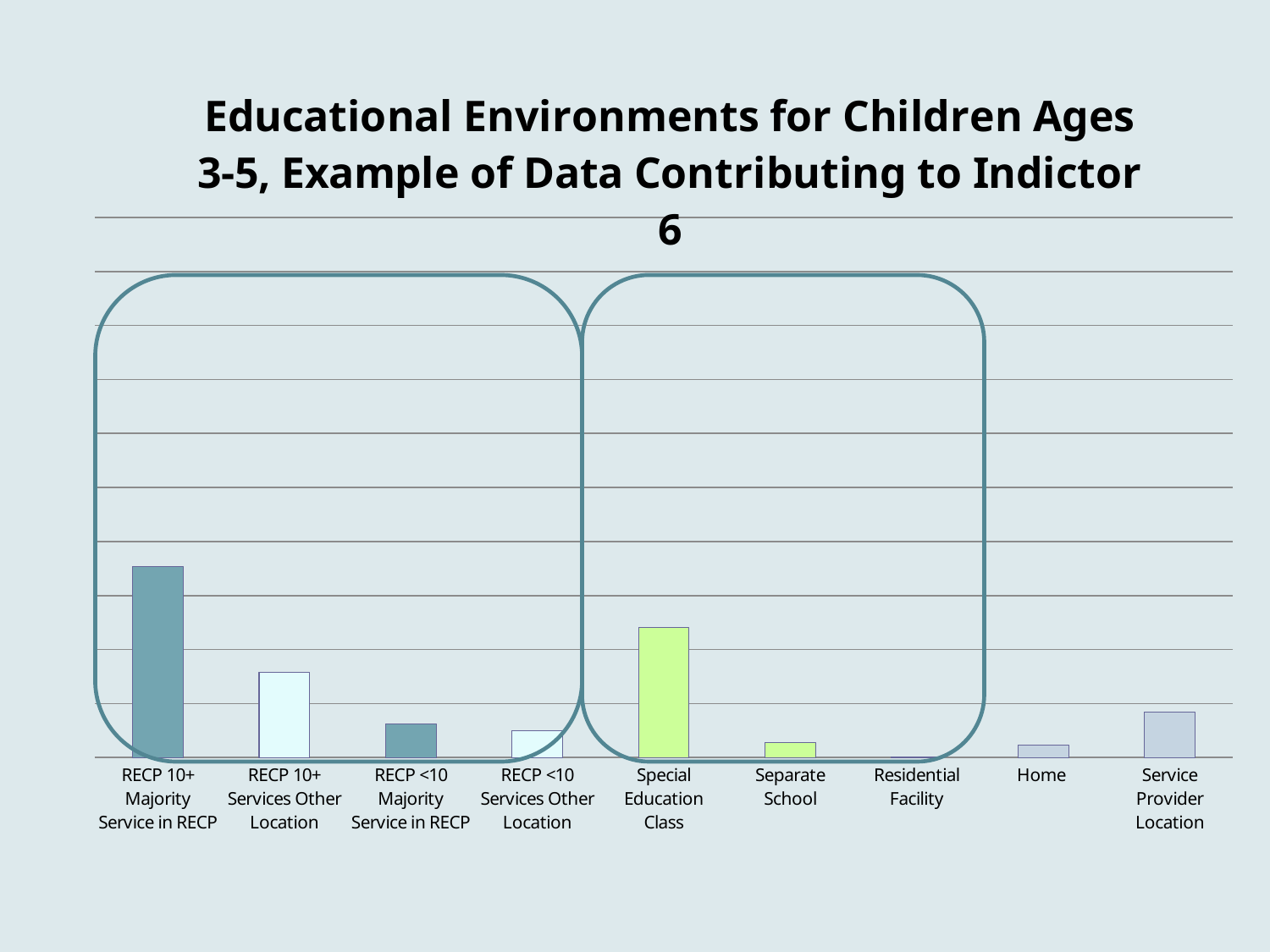
Which is larger, the bar for Special Education Class or the bar for Separate School? Special Education Class Which is larger, the bar for Home or the bar for Service Provider Location? Service Provider Location Among the first four categories (the RECP categories), which has the lowest bar? RECP <10 Services Other Location Which category has the lowest bar in the chart? Residential Facility Which is larger, the bar for RECP 10+ Services Other Location or the bar for RECP <10 Majority Service in RECP? RECP 10+ Services Other Location Which category has the highest bar in the chart? RECP 10+ Majority Service in RECP How many categories are shown on the x axis of the chart? 9 What kind of chart is shown on the slide? Bar chart What colour are the bars for Special Education Class and Separate School? Light green What is the title of the chart? Educational Environments for Children Ages 3-5, Example of Data Contributing to Indictor 6